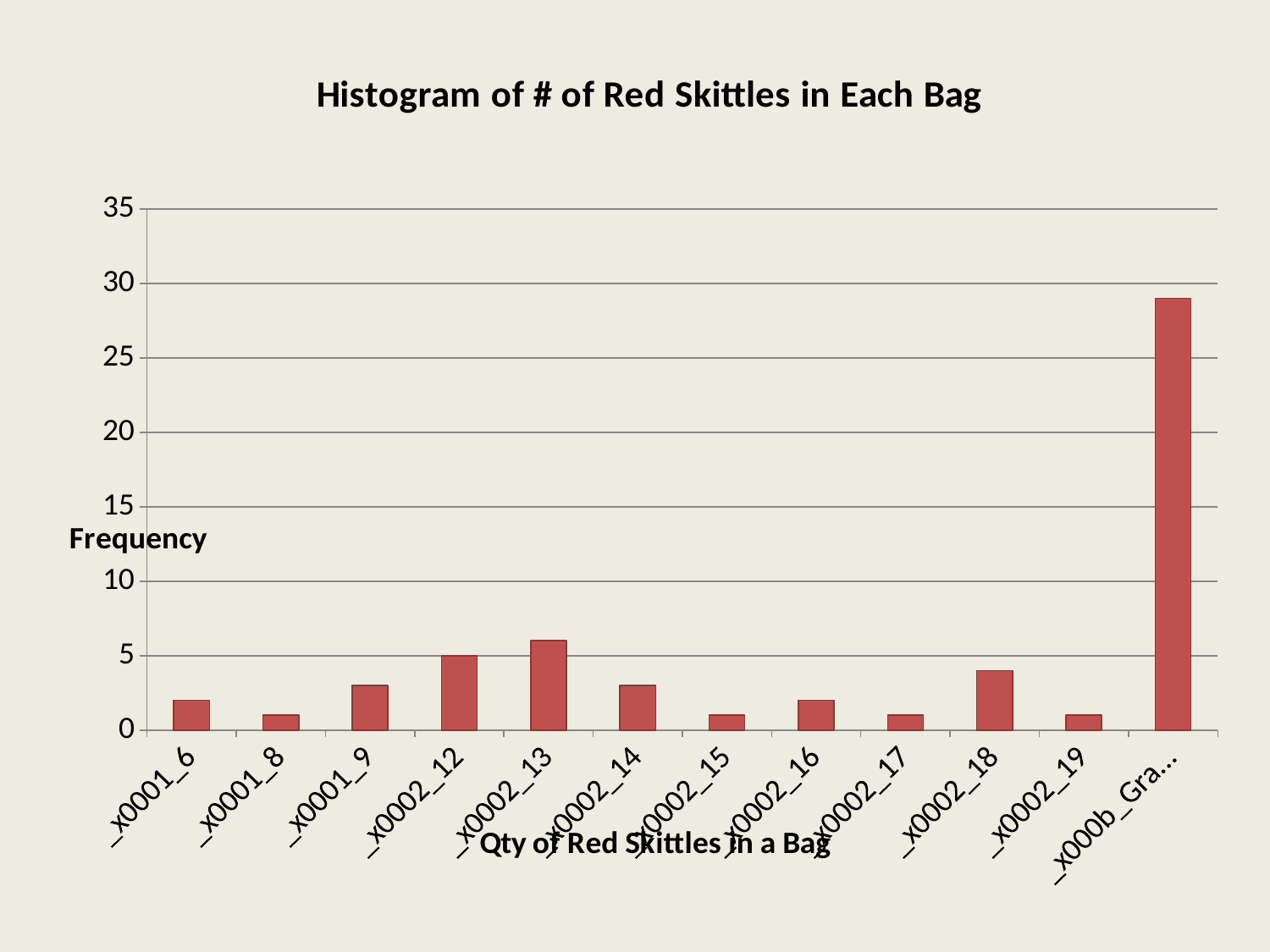
Which is larger, the value for _x0001_9 or the value for _x0002_18? _x0002_18 Is the value for _x0002_13 greater or less than 5? greater Is the value for _x000b_Gra... greater or less than 25? greater Which is larger, the value for _x0002_13 or the value for _x0002_15? _x0002_13 What is the frequency for the category _x0002_12? 5 Which category has the highest bar? _x000b_Gra... What is the title of the chart? Histogram of # of Red Skittles in Each Bag Is the value for _x0001_6 greater or less than 5? less What is the label of the vertical axis? Frequency How many categories are shown on the x axis? 12 What kind of chart is shown on the slide? bar chart